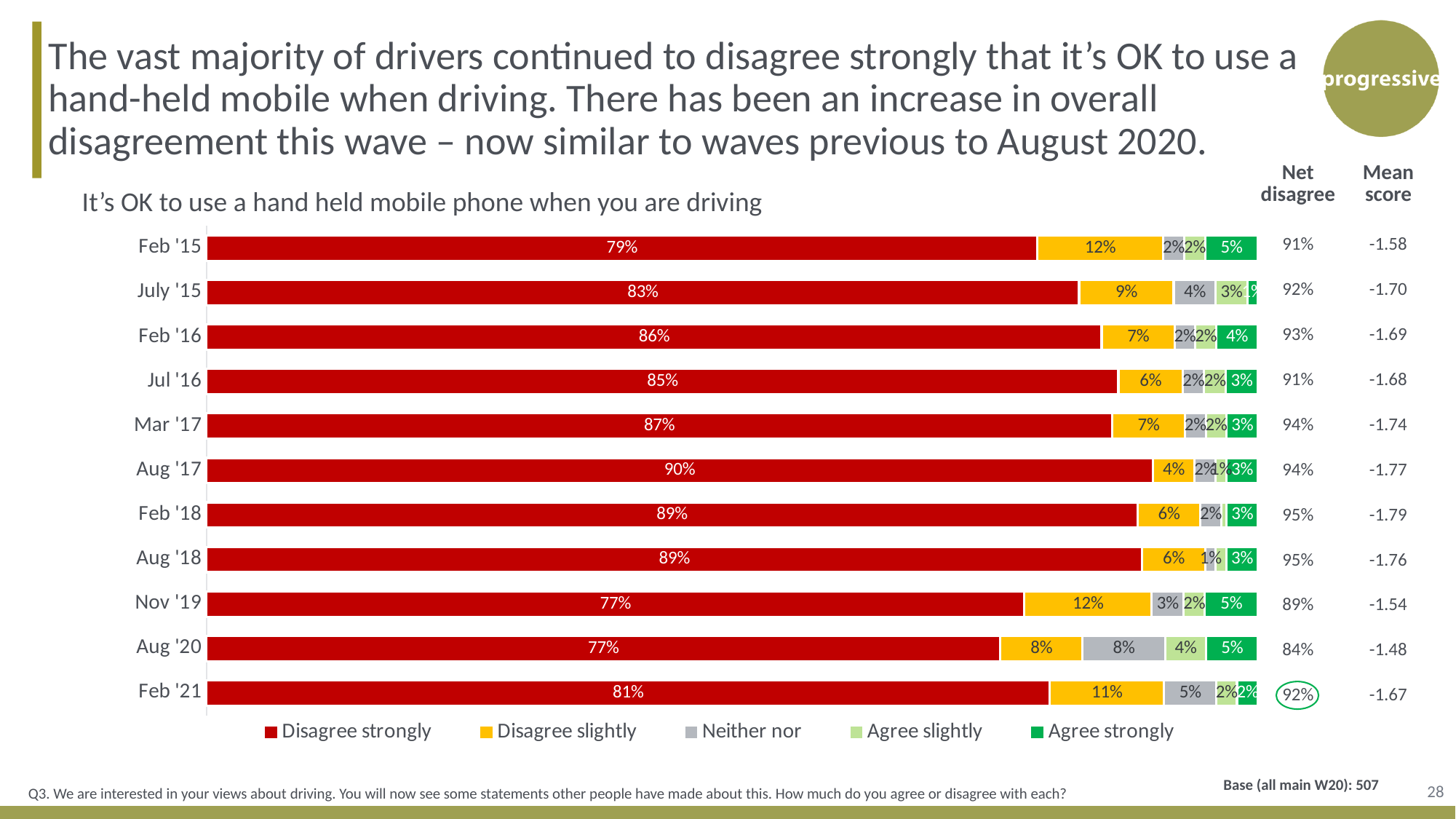
Which wave has the larger 'Disagree slightly' value, Feb '15 or Aug '20? Feb '15 What is the 'Disagree slightly' value for Nov '19? 12% What percentage of drivers said 'Disagree strongly' in Feb '21? 81% What is the Net disagree figure shown for Feb '21? 92% What is the difference in the 'Disagree strongly' percentage between Feb '21 and Aug '20? 4 percentage points How many survey waves (categories) are plotted on the chart? 11 What is the Mean score shown for Aug '20? -1.48 What is the 'Neither nor' value for Aug '20? 8% What kind of chart is shown on the slide? Stacked bar chart How many series does the chart legend list? 5 Which wave has the highest 'Disagree strongly' percentage? Aug '17 Which legend entry is shown in red? Disagree strongly